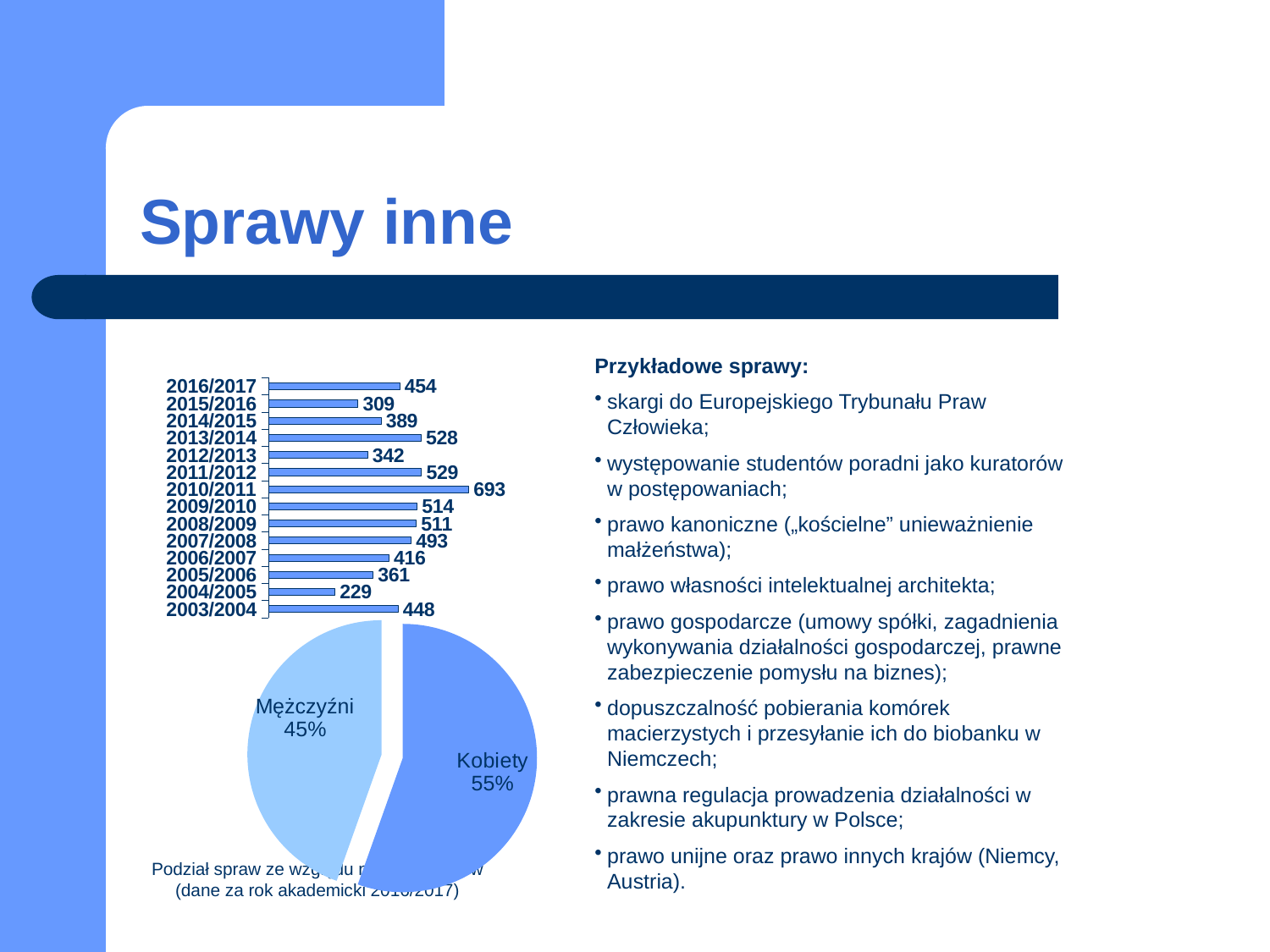
In the bar chart on the left of the slide, which academic year has the lowest value? 2004/2005 In the pie chart on the left of the slide, which slice is larger: Kobiety or Mężczyźni? Kobiety In the bar chart on the left of the slide, what is the value for 2004/2005? 229 In the bar chart on the left of the slide, what is the value for 2016/2017? 454 In the pie chart on the left of the slide, what share does Mężczyźni have? 45% In the pie chart on the left of the slide, what share does Kobiety have? 55% In the bar chart on the left of the slide, which academic year has the highest value? 2010/2011 How many slices does the pie chart on the left of the slide have? 2 In the bar chart on the left of the slide, which is larger: the value for 2013/2014 or the value for 2012/2013? 2013/2014 What kind of chart is the upper chart on the left of the slide? bar chart In the bar chart on the left of the slide, what is the difference between the values for 2010/2011 and 2015/2016? 384 How many academic years are shown in the bar chart on the left of the slide? 14